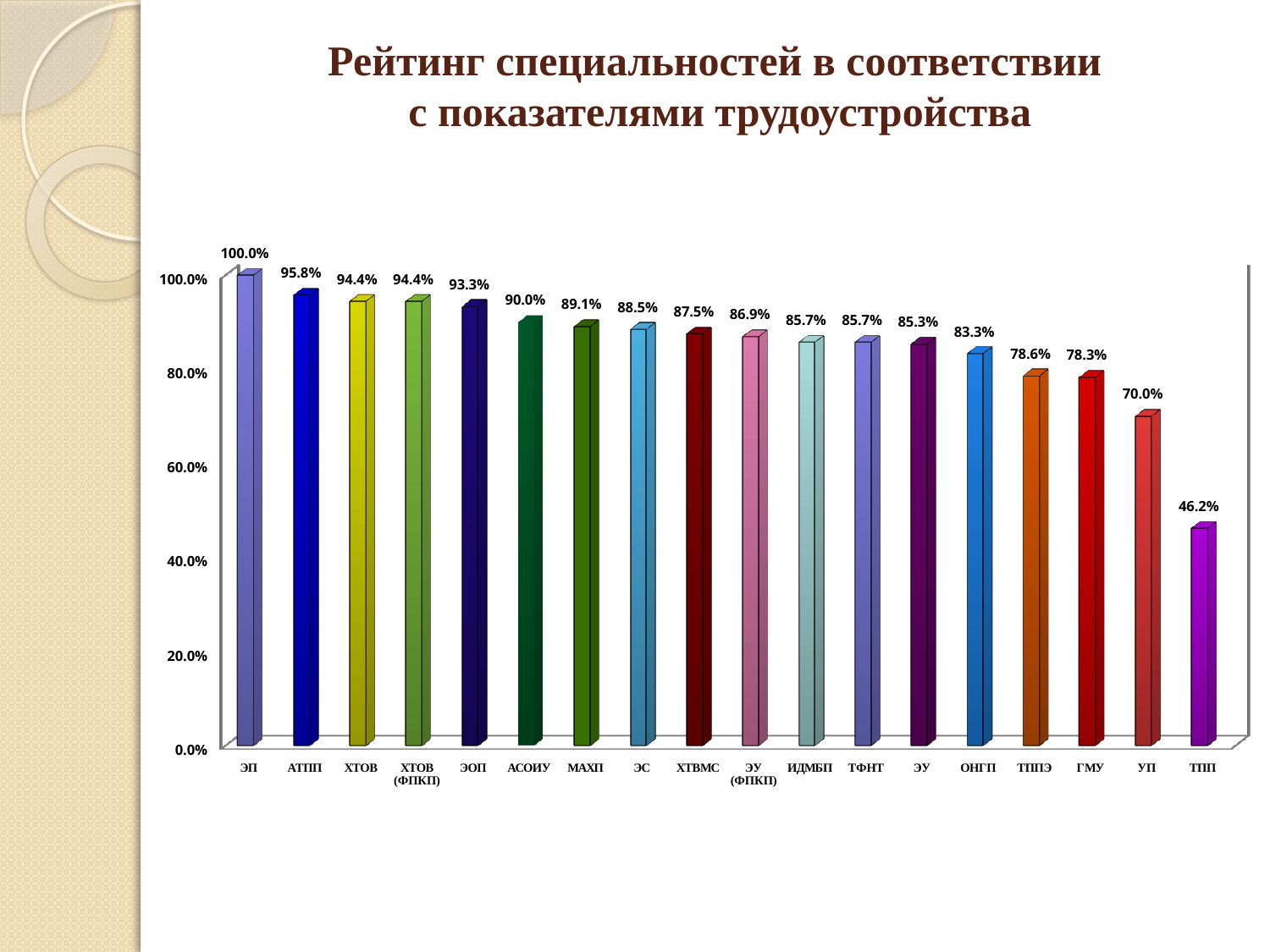
What kind of chart is shown on the slide? bar chart Which category has the highest value? ЭП Which category has the lowest value? ТПП What is the difference between the values for ЭП and ТПП? 53.8% What is the value for ОНГП? 83.3% Do the values rise or fall from left to right along the x axis? fall What is the value for АТПП? 95.8% What is the value for ТПП? 46.2% Is the value for ТПП greater or less than 60.0%? less Which is larger, the value for АСОИУ or the value for УП? АСОИУ How many categories are shown on the x axis? 18 What is the difference between the values for ТППЭ and ГМУ? 0.3%